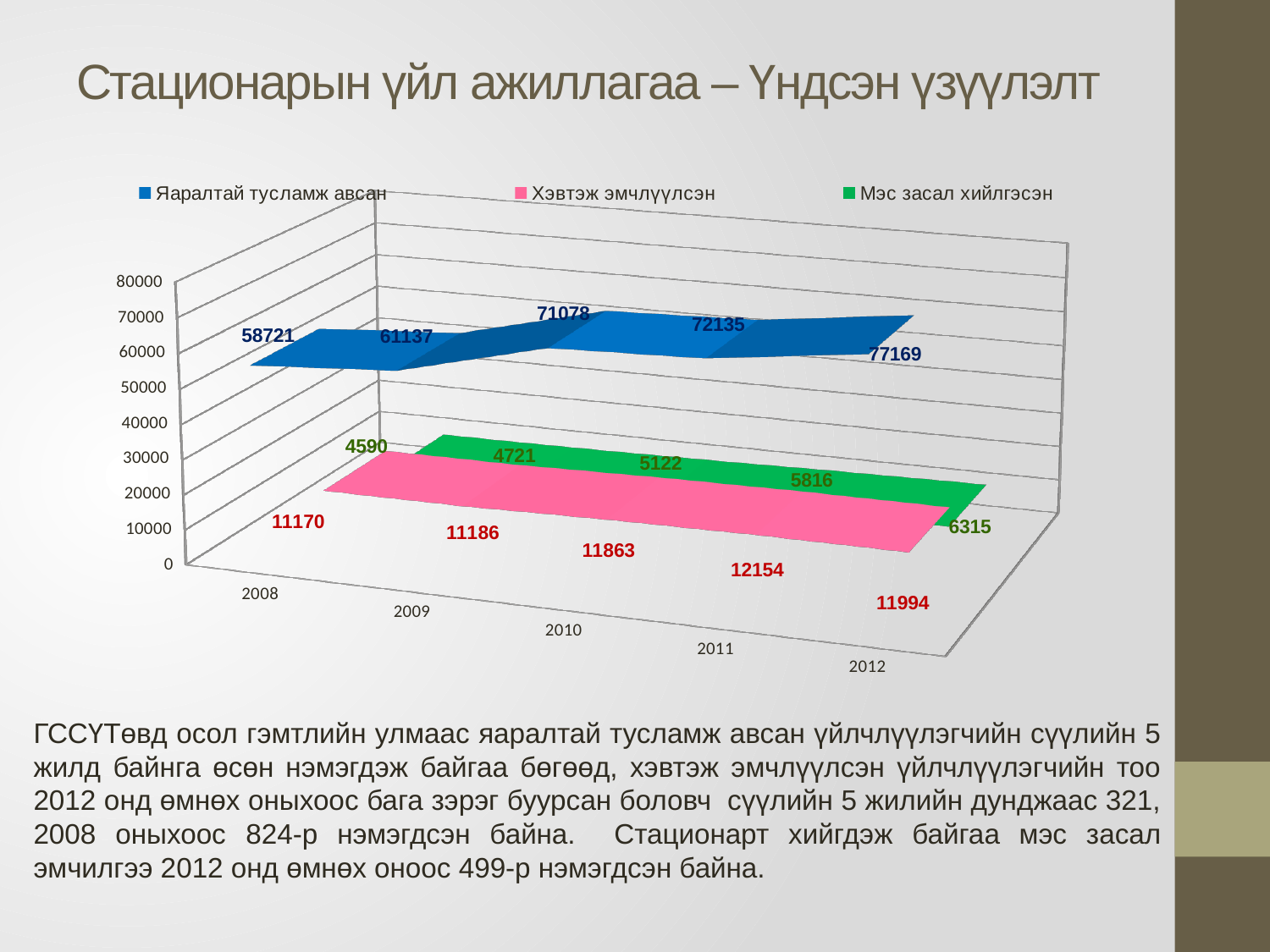
What is the difference between Яаралтай тусламж авсан in 2012 and in 2008? 18448 What is the value for Яаралтай тусламж авсан in 2012? 77169 What is the value for Мэс засал хийлгэсэн in 2008? 4590 How many series does the legend list? 3 In which year is Мэс засал хийлгэсэн lowest? 2008 Does the value for Мэс засал хийлгэсэн rise or fall from 2008 to 2012? rise What kind of chart is shown on the slide? 3D line chart Which is larger for Хэвтэж эмчлүүлсэн: the value in 2011 or the value in 2012? 2011 How many years are shown on the x axis? 5 Which series is shown in green in the legend? Мэс засал хийлгэсэн In which year is Яаралтай тусламж авсан highest? 2012 What is the value for Хэвтэж эмчлүүлсэн in 2011? 12154